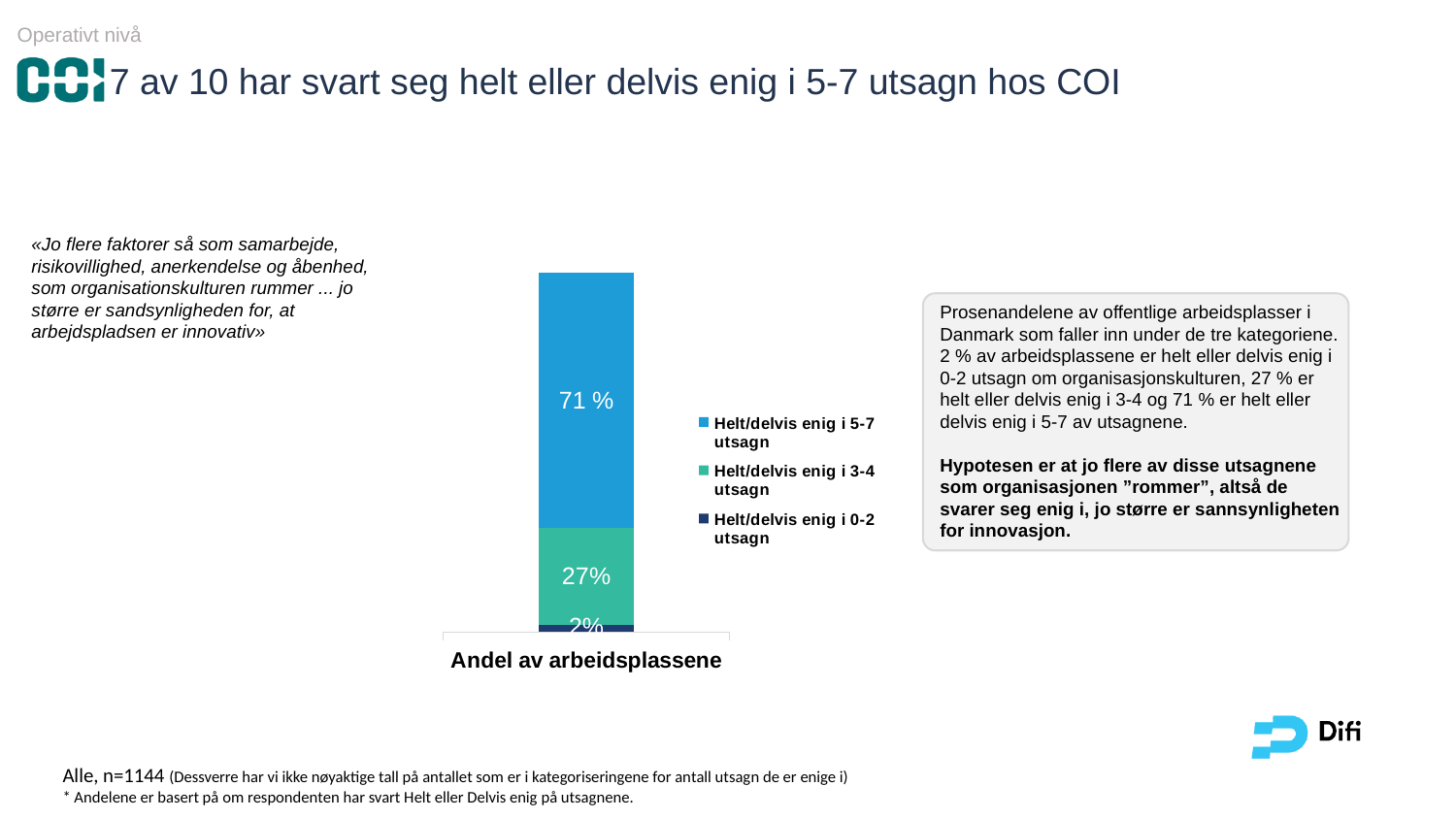
Which series has the largest share of the stacked bar? Helt/delvis enig i 5-7 utsagn How many series does the legend list? 3 What is the value for "Helt/delvis enig i 5-7 utsagn" in the chart? 71 % What is the value for "Helt/delvis enig i 0-2 utsagn" in the chart? 2% Which is larger: the value for "Helt/delvis enig i 3-4 utsagn" or "Helt/delvis enig i 0-2 utsagn"? Helt/delvis enig i 3-4 utsagn What is the label of the category on the x axis of the chart? Andel av arbeidsplassene Which series has the smallest share of the stacked bar? Helt/delvis enig i 0-2 utsagn What is the value for "Helt/delvis enig i 3-4 utsagn" in the chart? 27% What is the total of the stacked bar "Andel av arbeidsplassene"? 100% What is the difference between the values for "Helt/delvis enig i 5-7 utsagn" and "Helt/delvis enig i 3-4 utsagn"? 44 percentage points How many categories are shown on the x axis of the chart? 1 What type of chart is shown on the slide? Stacked bar chart